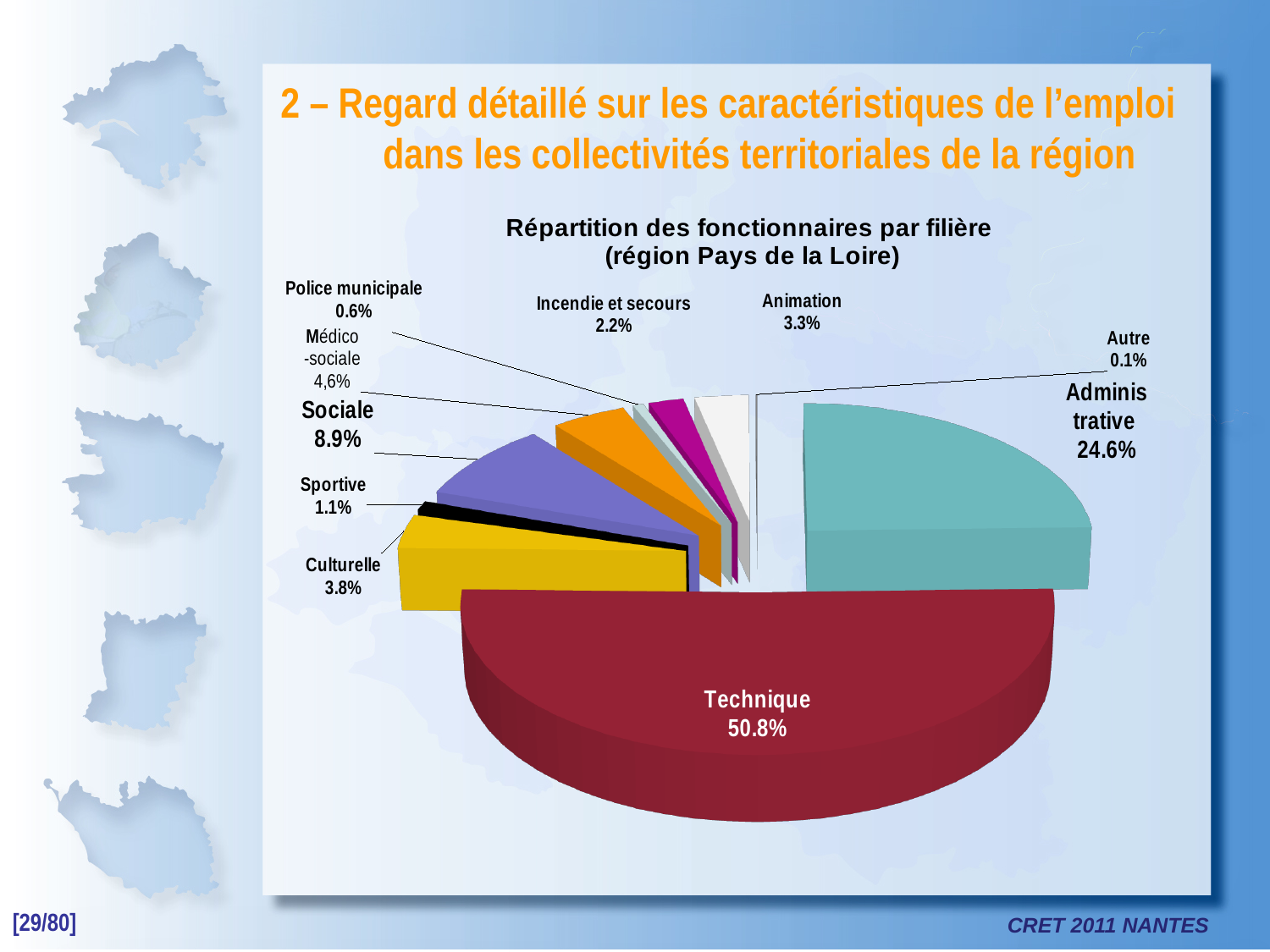
What is the value shown for Incendie et secours? 2.2% What is the value shown for Sociale? 8.9% What share of the pie does the Technique slice represent? 50.8% Which category has the smallest share of the pie? Autre What is the value shown for Police municipale? 0.6% Which category has the largest share of the pie? Technique What is the value shown for Administrative? 24.6% How many categories (slices) does the pie chart show? 10 What is the difference between the Technique and Administrative shares? 26.2% Which is larger, Culturelle or Animation? Culturelle What kind of chart is shown on the slide? pie chart What is the title of the chart? Répartition des fonctionnaires par filière (région Pays de la Loire)